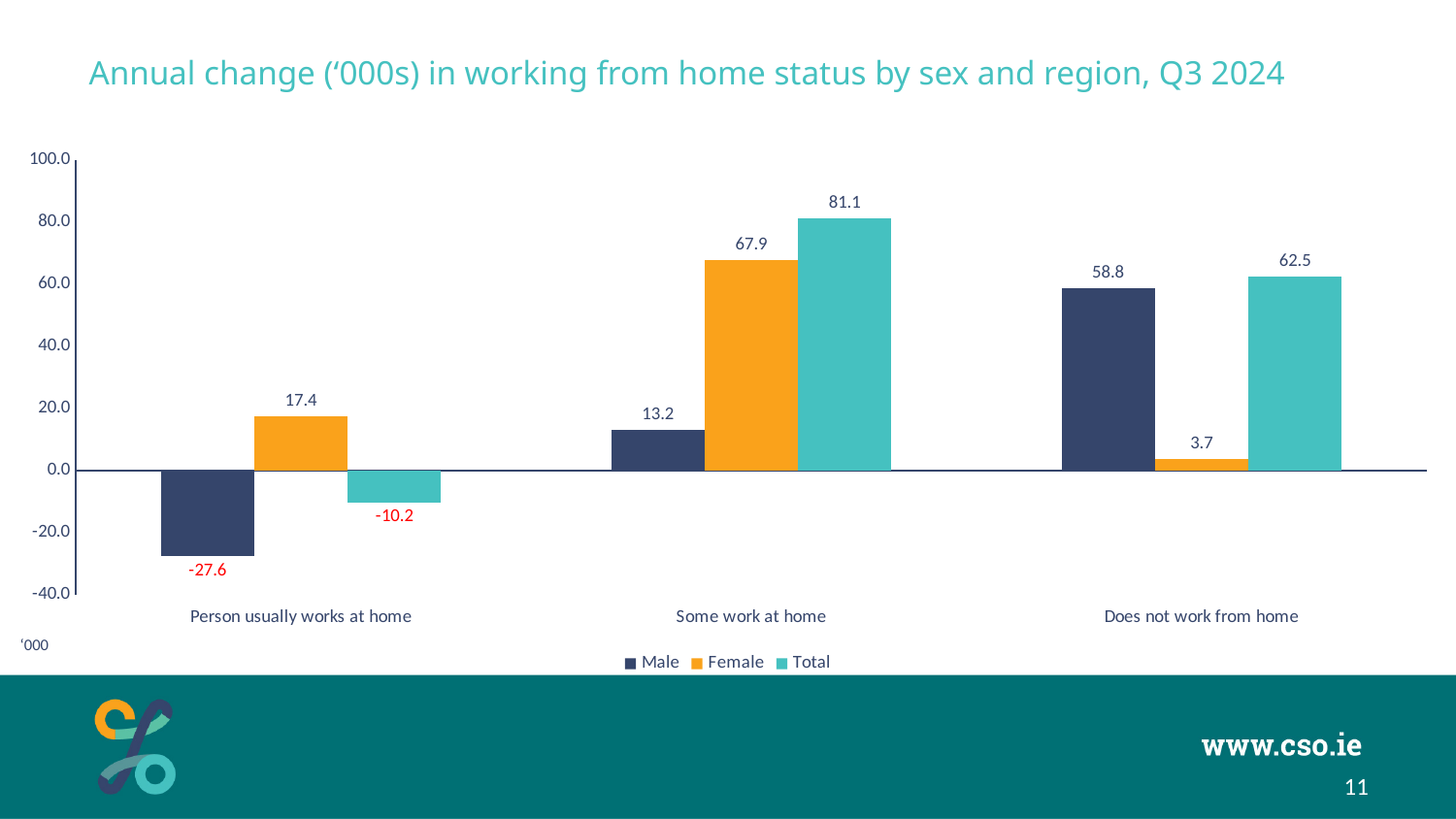
Which category has the highest Total value? Some work at home How many categories are shown on the x axis? 3 What kind of chart is shown on the slide? Bar chart What is the Female value for 'Does not work from home'? 3.7 What is the Male value for 'Person usually works at home'? -27.6 Which category has the lowest Male value? Person usually works at home How many series does the legend list? 3 What is the title of the chart? Annual change ('000s) in working from home status by sex and region, Q3 2024 What is the difference between the Total and Male values for 'Some work at home'? 67.9 Which is larger for 'Does not work from home': the Male value or the Total value? Total What is the Female value for 'Some work at home'? 67.9 What is the Total value for 'Does not work from home'? 62.5